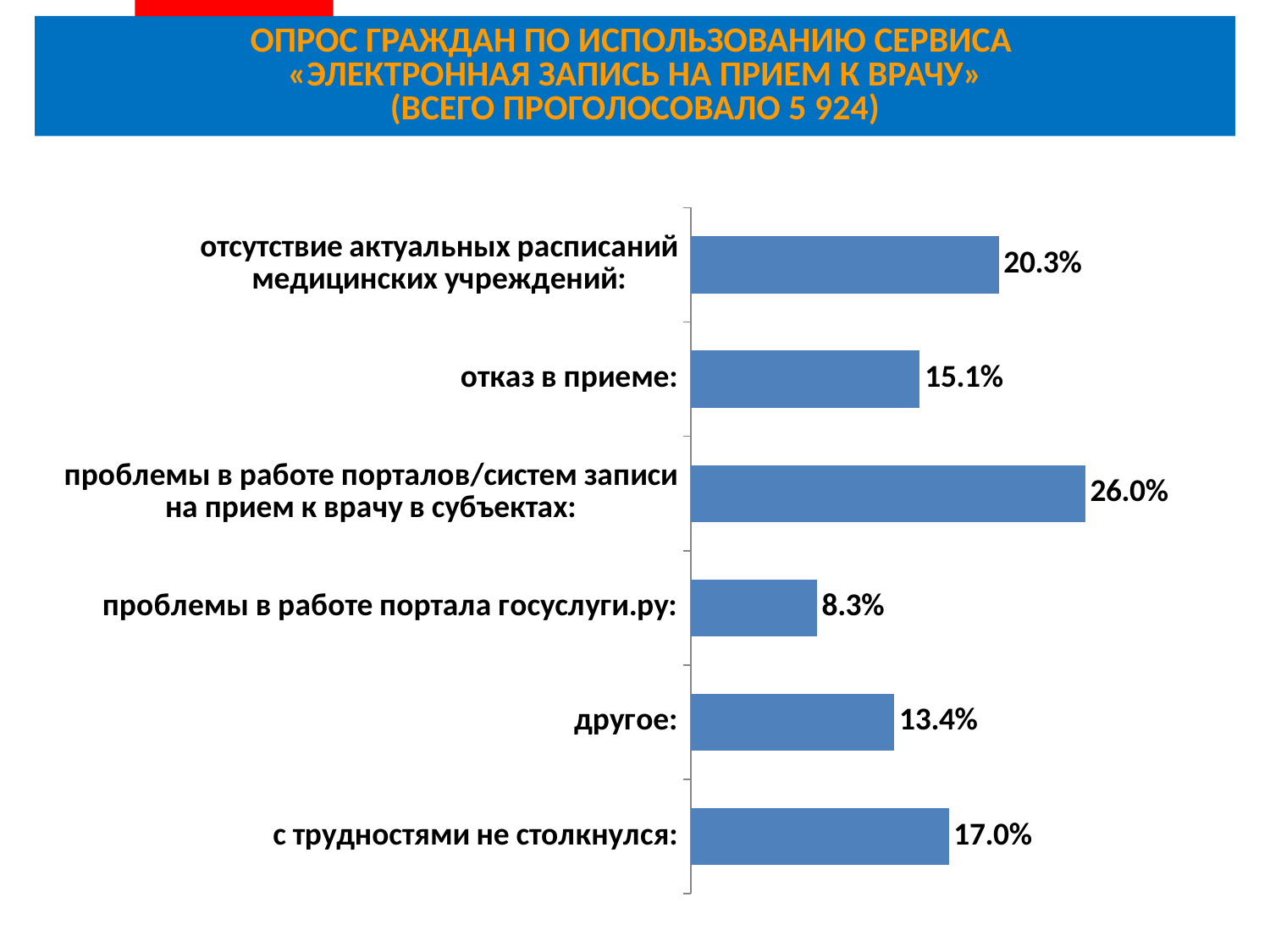
What is the difference between the values for «проблемы в работе порталов/систем записи на прием к врачу в субъектах» and «отсутствие актуальных расписаний медицинских учреждений»? 5.7% What is the value for «отсутствие актуальных расписаний медицинских учреждений»? 20.3% Which category has the highest value? проблемы в работе порталов/систем записи на прием к врачу в субъектах What is the value for «проблемы в работе портала госуслуги.ру»? 8.3% What is the value for «с трудностями не столкнулся»? 17.0% Which is larger: the value for «отказ в приеме» or the value for «другое»? отказ в приеме What kind of chart is shown on the slide? bar chart How many categories are shown in the chart? 6 What is the value for «отказ в приеме»? 15.1% Which category has the lowest value? проблемы в работе портала госуслуги.ру According to the slide title, how many people voted in total? 5 924 What is the difference between the values for «с трудностями не столкнулся» and «другое»? 3.6%